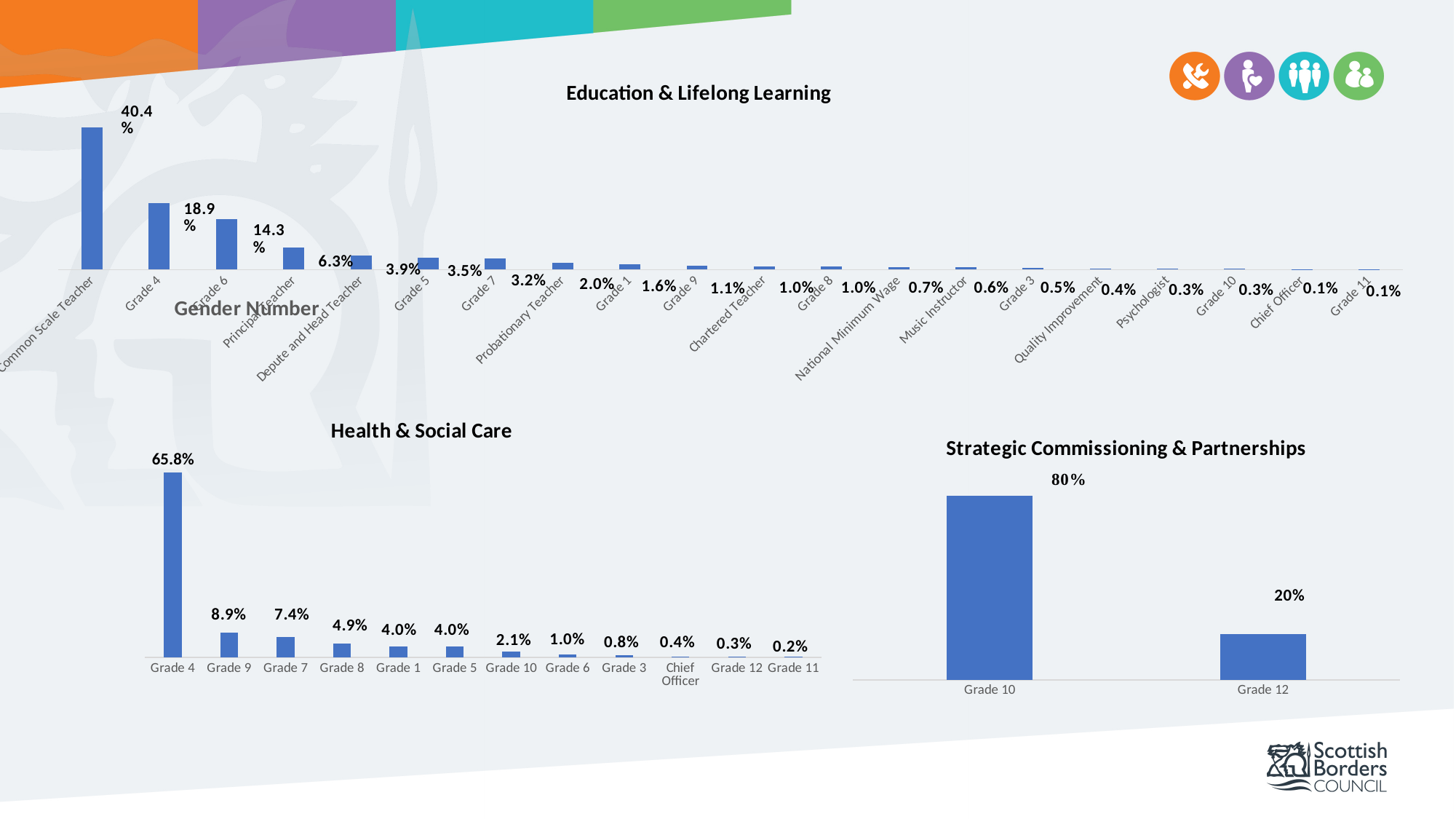
What type of chart is the Strategic Commissioning & Partnerships chart? Bar chart In the Health & Social Care chart, which category has the lowest value? Grade 11 In the Health & Social Care chart, which category has the highest value? Grade 4 How many categories are shown in the Strategic Commissioning & Partnerships chart? 2 In the Education & Lifelong Learning chart, what is the value for Common Scale Teacher? 40.4% In the Strategic Commissioning & Partnerships chart, what is the value for Grade 12? 20% In the Health & Social Care chart, what is the value for Grade 4? 65.8% In the Health & Social Care chart, which is larger, Grade 10 or Grade 6? Grade 10 In the Health & Social Care chart, what is the difference between Grade 9 and Grade 8? 4.0% In the Strategic Commissioning & Partnerships chart, what is the difference between Grade 10 and Grade 12? 60% How many categories are shown in the Health & Social Care chart? 12 In the Health & Social Care chart, what is the value for Grade 7? 7.4%